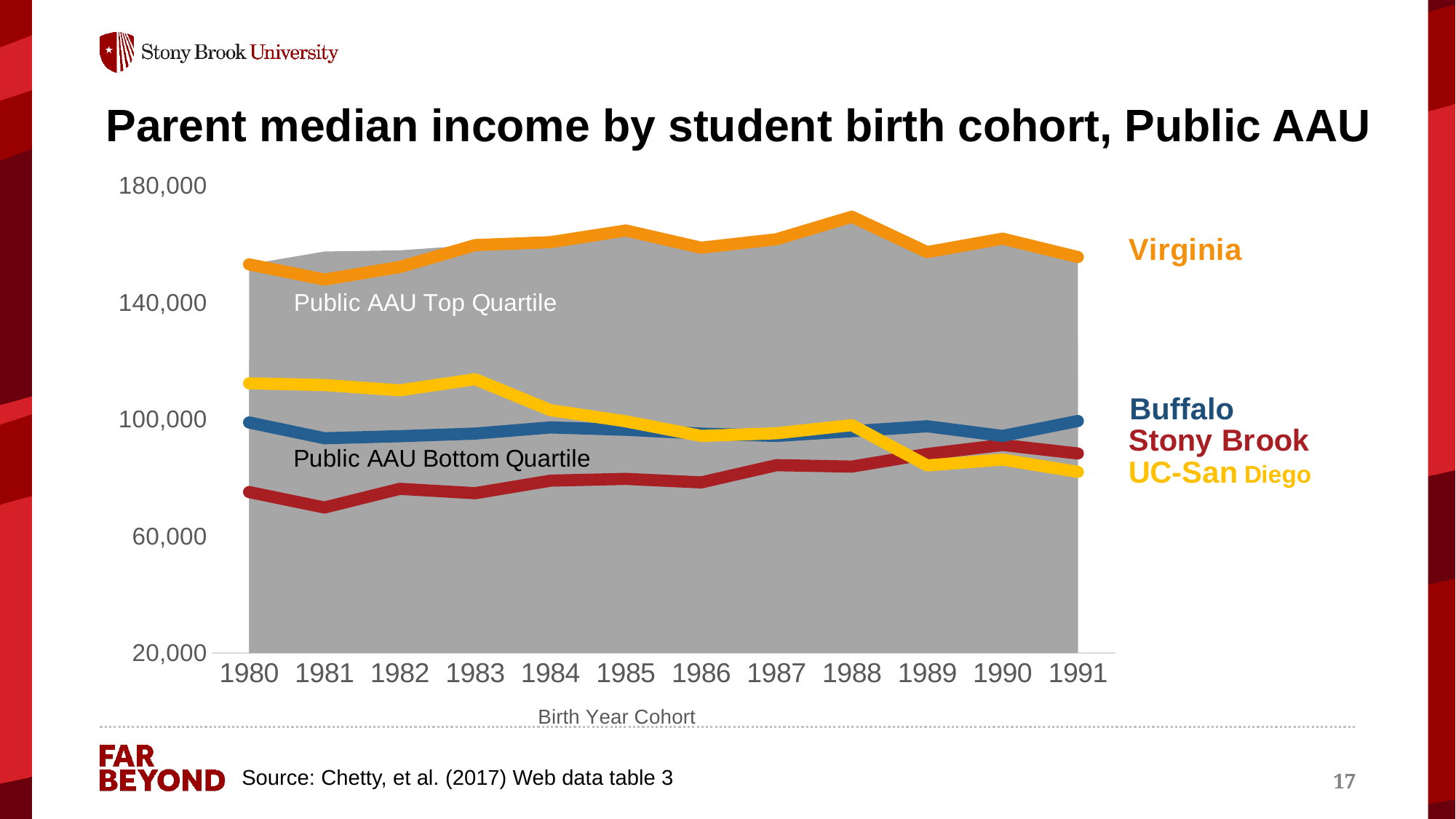
Which university has the highest parent median income across all birth cohorts? Virginia What kind of chart is shown on the slide? line chart How many universities are labelled as line series on the chart? 4 For the 1991 birth cohort, which is larger: Buffalo or UC-San Diego? Buffalo Is the value for Stony Brook in 1981 greater or less than 100,000? less How many birth year cohorts are shown on the x axis? 12 Does the UC-San Diego line rise or fall overall from 1980 to 1991? fall What is the label of the x axis? Birth Year Cohort Which university has the lowest parent median income for the 1980 birth cohort? Stony Brook Which university has the lowest parent median income for the 1991 birth cohort? UC-San Diego Is the value for Virginia in 1988 greater or less than 140,000? greater Is the value for UC-San Diego in 1980 greater or less than 100,000? greater